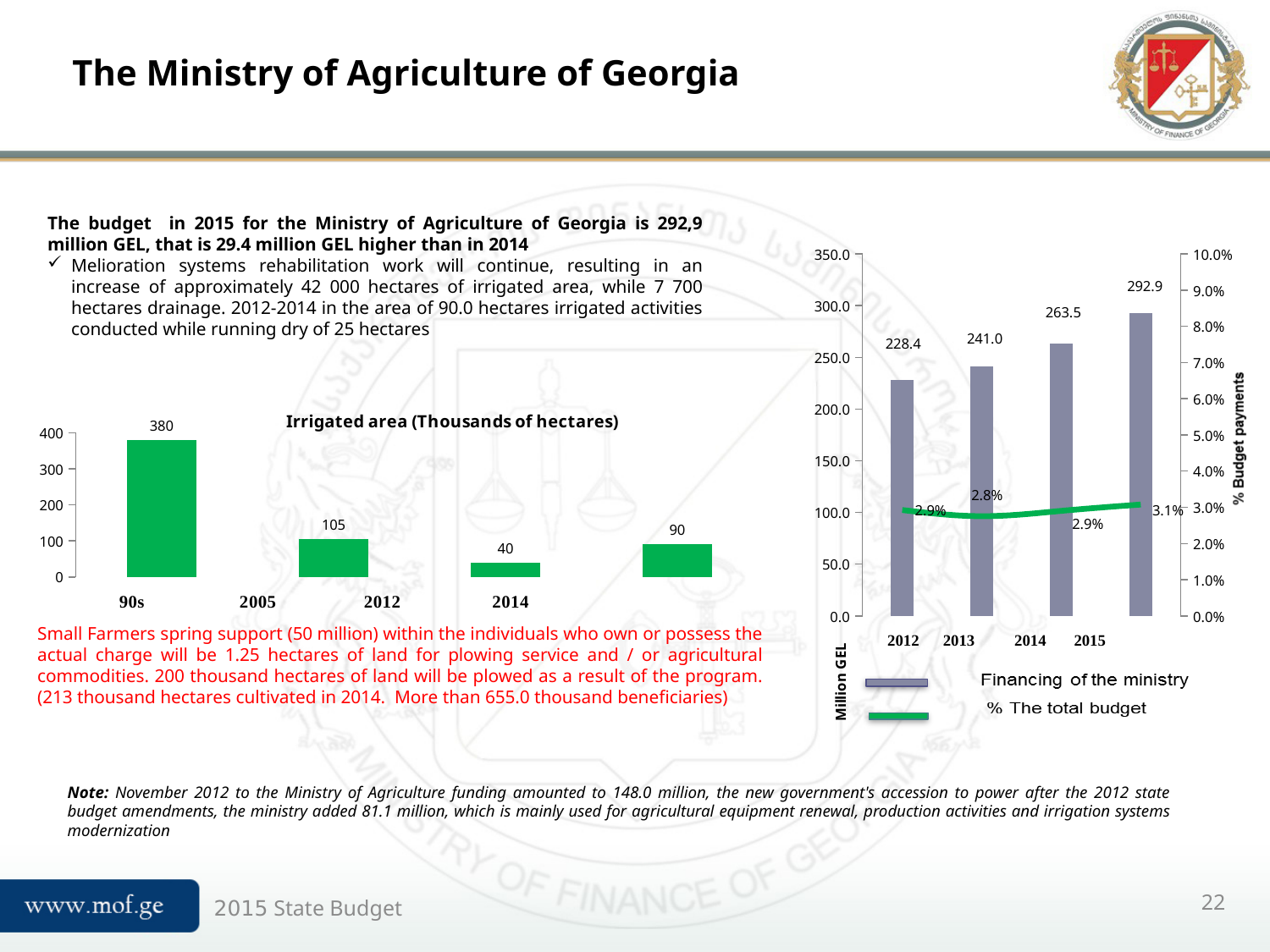
In the 'Irrigated area (Thousands of hectares)' chart, what is the lowest value shown? 40 In the right-hand chart, what is the financing of the ministry in 2012? 228.4 In the right-hand chart, which year has the highest financing of the ministry? 2015 What kind of chart is the 'Irrigated area (Thousands of hectares)' chart? bar chart In the right-hand chart, what percentage of the total budget does the ministry's financing represent in 2013? 2.8% In the right-hand chart, does the financing of the ministry rise or fall from 2012 to 2015? rise In the right-hand chart, what is the difference in financing of the ministry between 2015 and 2014? 29.4 In the 'Irrigated area (Thousands of hectares)' chart, what is the highest value shown? 380 In the right-hand chart, what is the financing of the ministry in 2015 (million GEL)? 292.9 How many series does the legend of the right-hand chart list? 2 In the right-hand chart, what percentage of the total budget does the ministry's financing represent in 2015? 3.1% In the right-hand chart, which year has the lowest share of the total budget? 2013